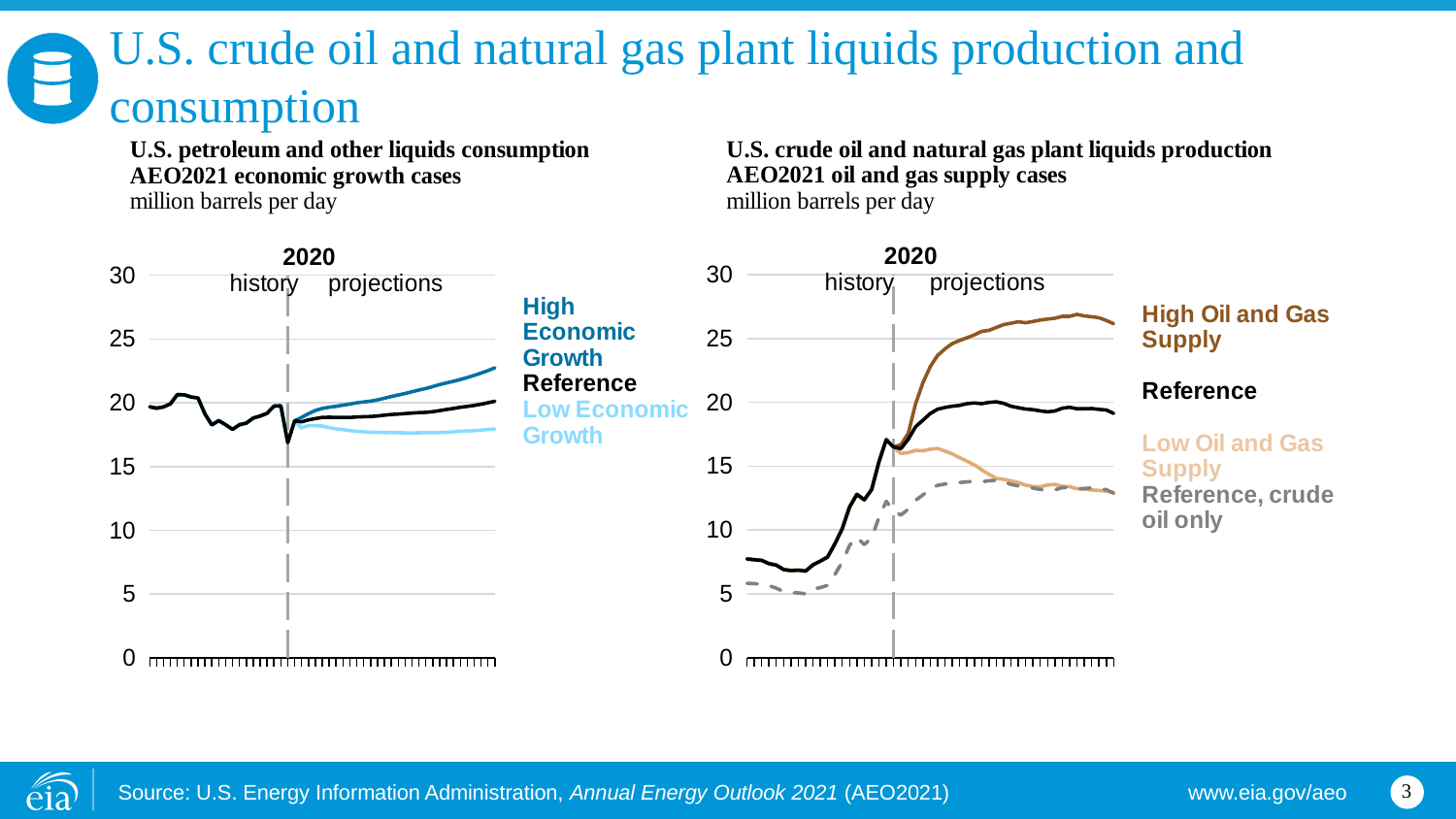
In the right chart, 'U.S. crude oil and natural gas plant liquids production', is the value for Low Oil and Gas Supply at the end of the projection period greater or less than 15? less What unit is used on both charts? million barrels per day In the right chart, 'U.S. crude oil and natural gas plant liquids production', is the value for High Oil and Gas Supply at the end of the projection period greater or less than 25? greater What kind of chart is the left chart, 'U.S. petroleum and other liquids consumption'? line chart In the right chart, 'U.S. crude oil and natural gas plant liquids production', does the High Oil and Gas Supply series rise or fall over the projection period? rise In the right chart, 'U.S. crude oil and natural gas plant liquids production', which series is highest at the end of the projection period? High Oil and Gas Supply How many series does the legend of the right chart, 'U.S. crude oil and natural gas plant liquids production', list? 4 In the left chart, 'U.S. petroleum and other liquids consumption', is the value for High Economic Growth at the end of the projection period greater or less than 20? greater In the left chart, 'U.S. petroleum and other liquids consumption', which is larger at the end of the projection period: High Economic Growth or Low Economic Growth? High Economic Growth How many series does the legend of the left chart, 'U.S. petroleum and other liquids consumption', list? 3